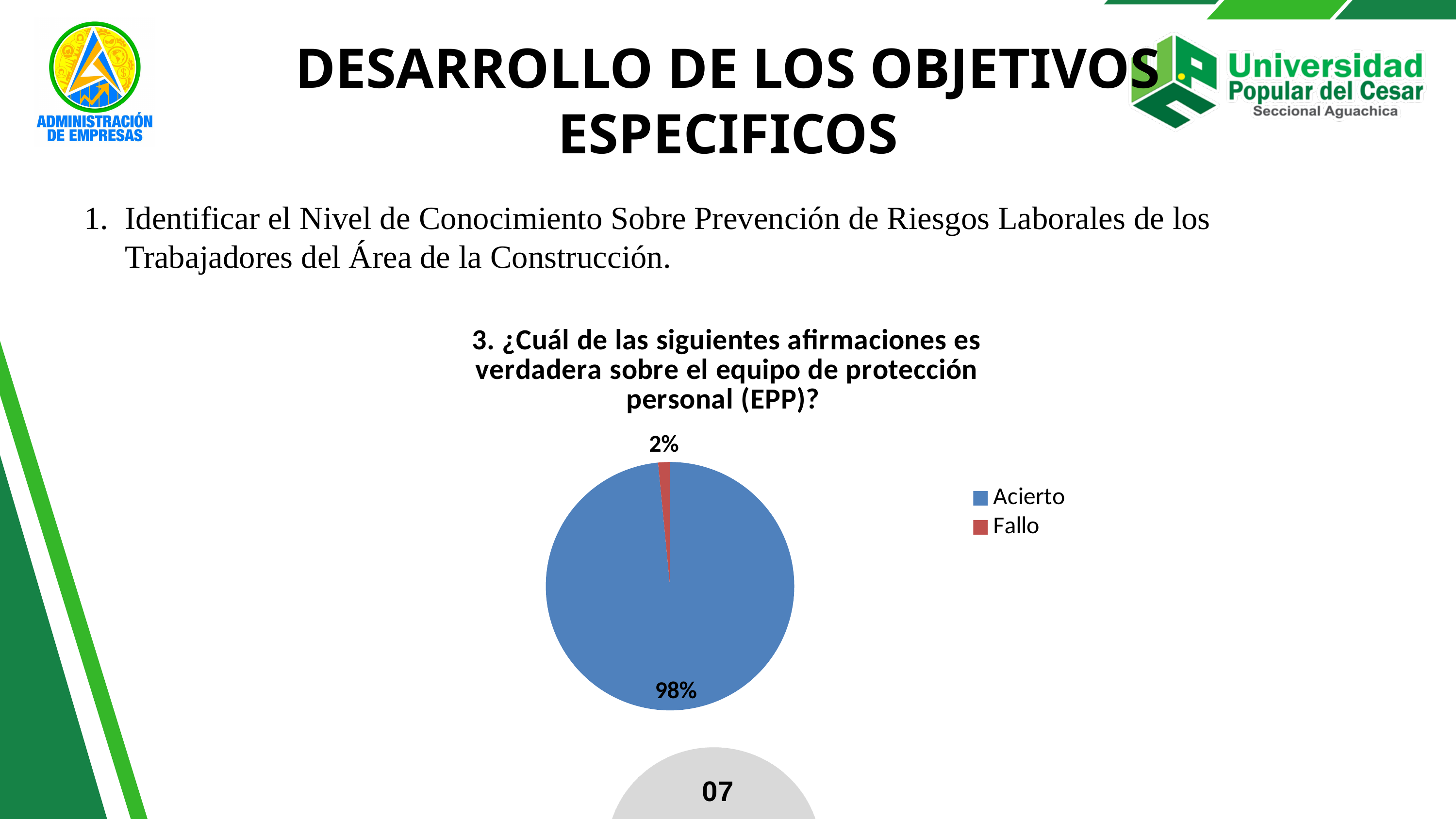
What is the difference in percentage points between Acierto and Fallo? 96 What percentage of the pie chart is labelled Fallo? 2% What is the title of the pie chart? 3. ¿Cuál de las siguientes afirmaciones es verdadera sobre el equipo de protección personal (EPP)? How many categories does the pie chart show? 2 What colour is the Acierto slice in the pie chart? Blue Which is larger, the share for Acierto or the share for Fallo? Acierto What kind of chart is shown on the slide? Pie chart How many entries does the legend list? 2 What share of the pie does the Fallo slice represent? 2% Which category has the largest share of the pie chart? Acierto Which category has the smallest share of the pie chart? Fallo What percentage of the pie chart is labelled Acierto? 98%